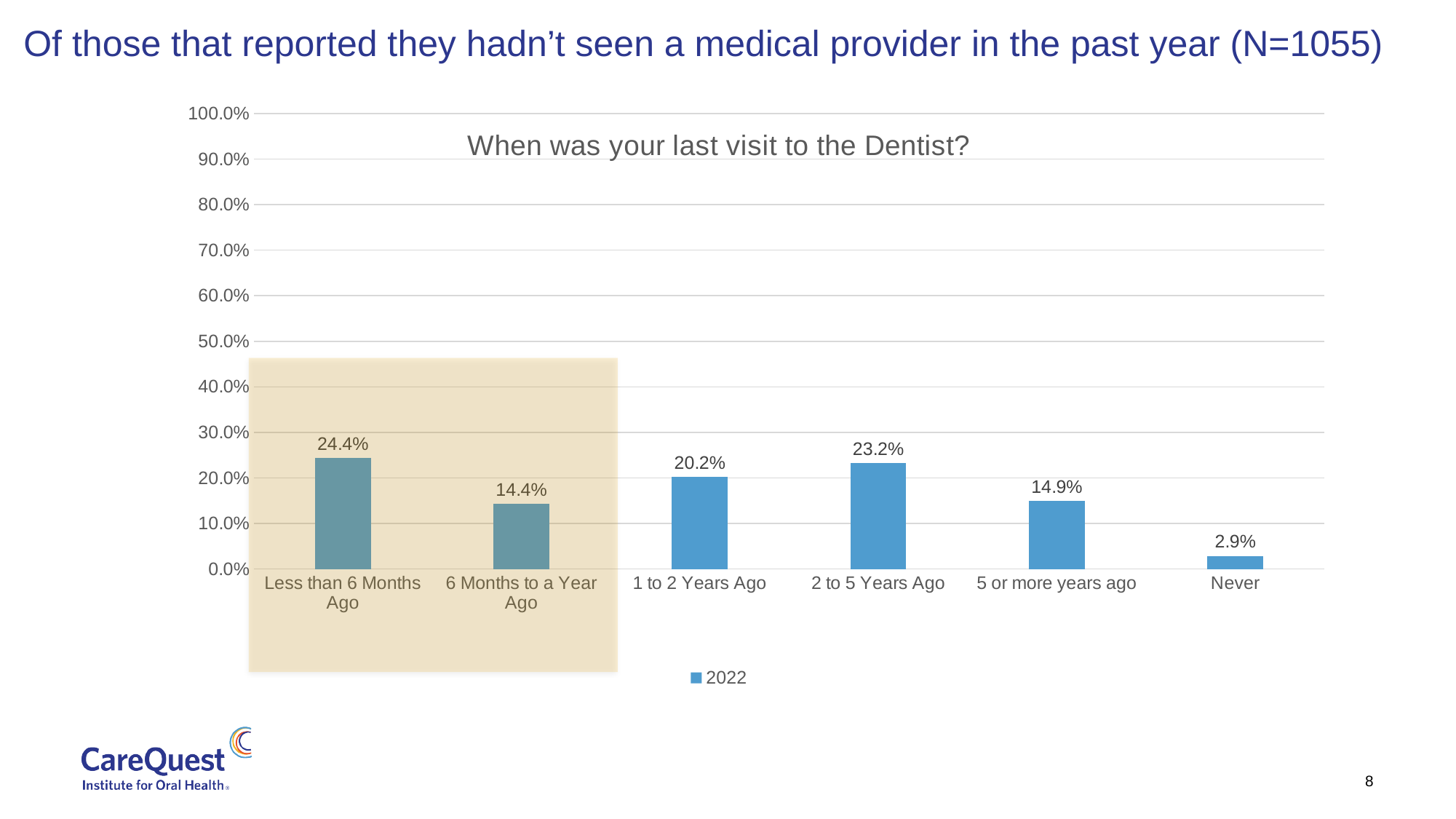
Which category has the lowest value? Never What is the value for "2 to 5 Years Ago"? 23.2% What is the value for "6 Months to a Year Ago"? 14.4% What is the value for "Never"? 2.9% Which is larger, the value for "1 to 2 Years Ago" or the value for "5 or more years ago"? 1 to 2 Years Ago How many series does the legend list? 1 Which category has the highest value? Less than 6 Months Ago How many categories are shown on the x axis? 6 What is the title of the chart? When was your last visit to the Dentist? What is the value for "Less than 6 Months Ago"? 24.4% What kind of chart is shown? Bar chart What is the difference between the values for "Less than 6 Months Ago" and "6 Months to a Year Ago"? 10.0%